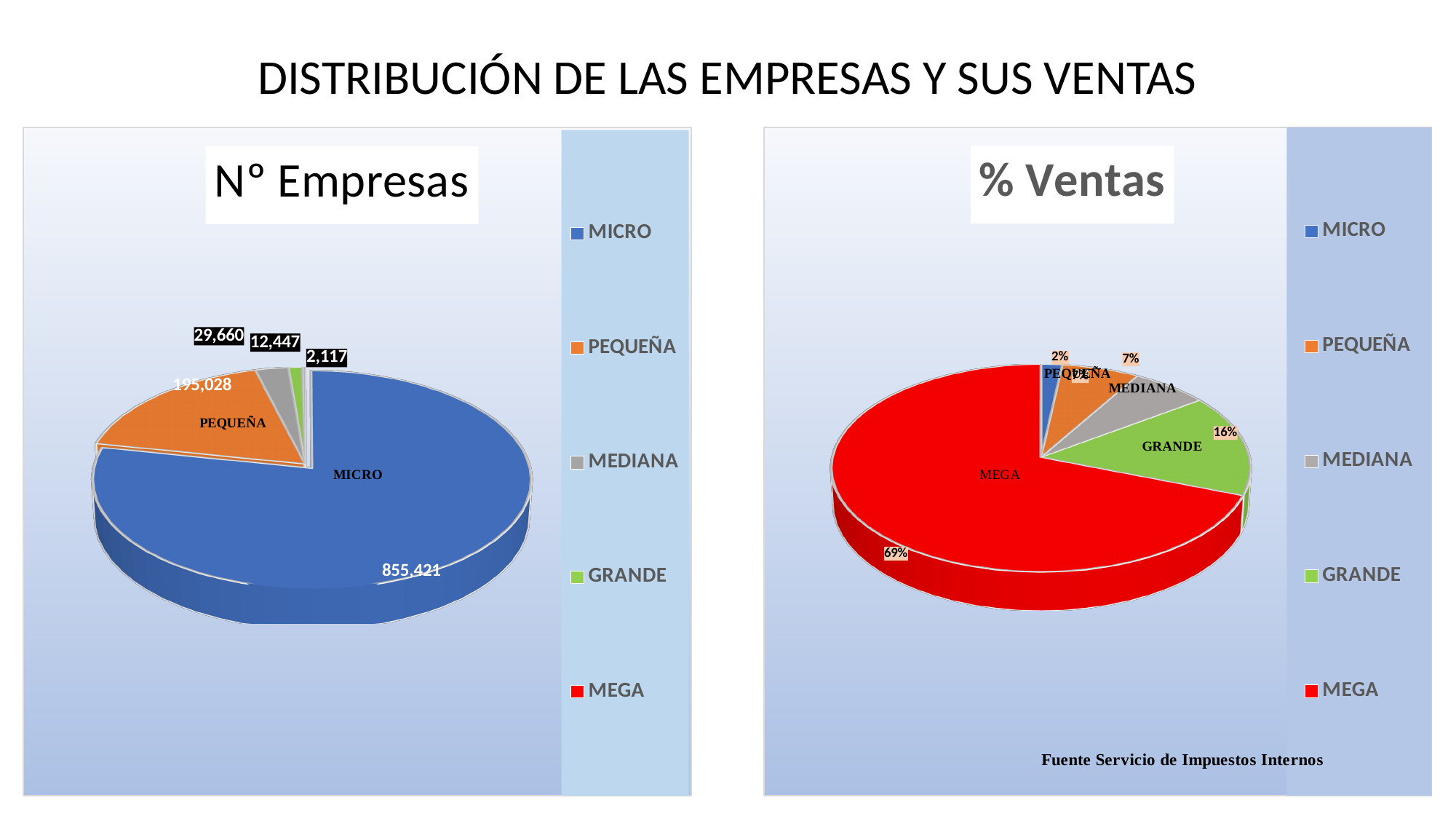
In the N° Empresas chart, which category has the largest slice? MICRO In the % Ventas chart, which category has the largest share? MEGA In the N° Empresas chart, what is the value for MICRO? 855,421 In the N° Empresas chart, which category has the smallest slice? MEGA In the % Ventas chart, what share of sales does GRANDE have? 16% In the % Ventas chart, what share of sales does MICRO have? 2% In the N° Empresas chart, what is the value for MEGA? 2,117 In the N° Empresas chart, what is the value for MEDIANA? 29,660 In the N° Empresas chart, what is the difference between MEDIANA and GRANDE? 17,213 How many categories does the legend of the N° Empresas chart list? 5 In the % Ventas chart, what share of sales does MEGA have? 69% In the N° Empresas chart, what is the value for PEQUEÑA? 195,028